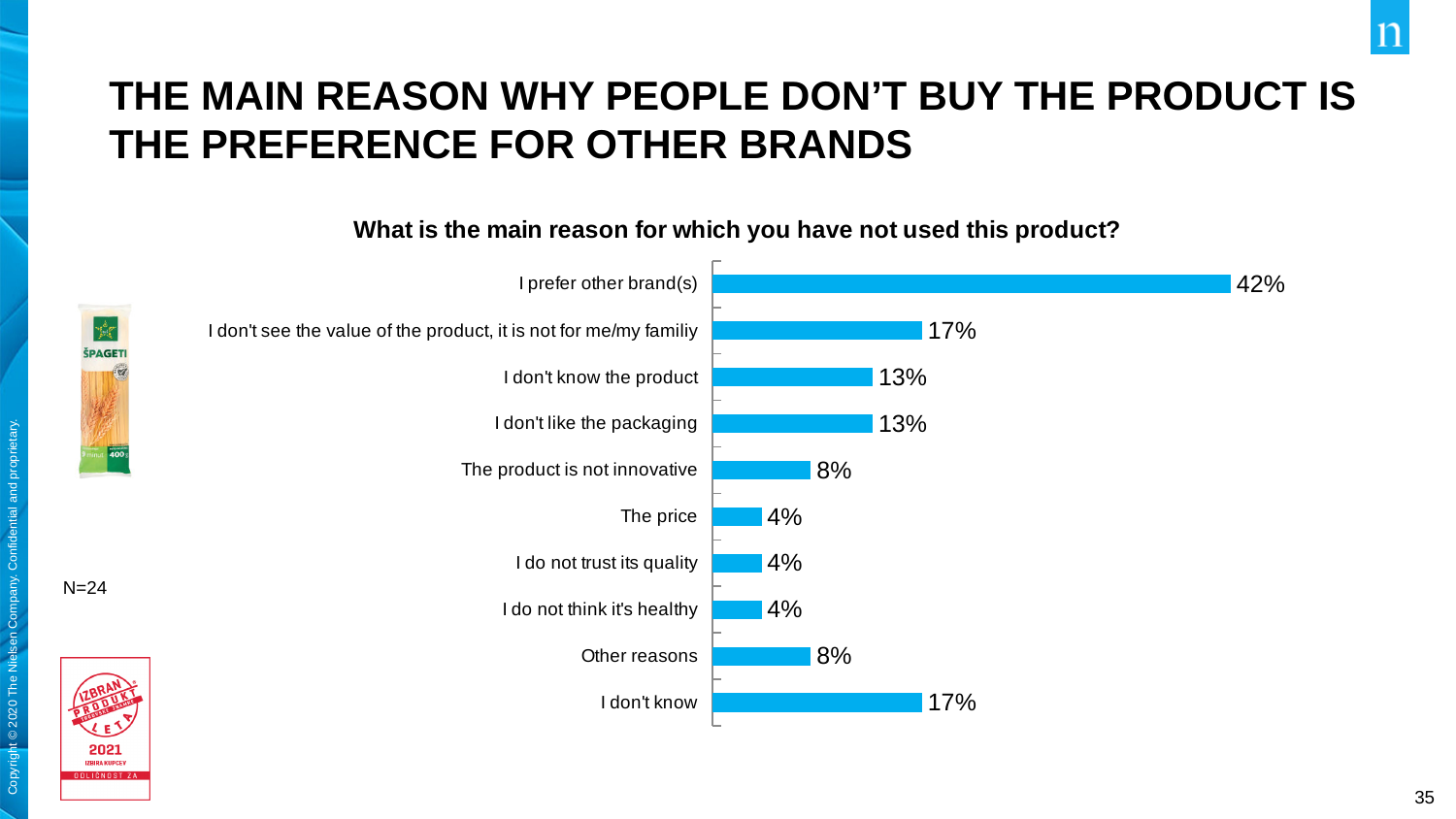
What type of chart is shown on the slide? Bar chart How many reasons (categories) are shown in the chart? 10 What is the value for "I don't know"? 17% What is the sample size (N) shown on the slide? N=24 What percentage of respondents said "I prefer other brand(s)"? 42% What is the value for "I don't know the product"? 13% What is the value for "Other reasons"? 8% What percentage chose "The price" as the main reason? 4% Which reason has the highest percentage? I prefer other brand(s) Which is larger: "The product is not innovative" or "I do not trust its quality"? The product is not innovative What is the difference between "I don't like the packaging" and "I do not think it's healthy"? 9% What is the difference between "I prefer other brand(s)" and "I don't see the value of the product, it is not for me/my familiy"? 25%